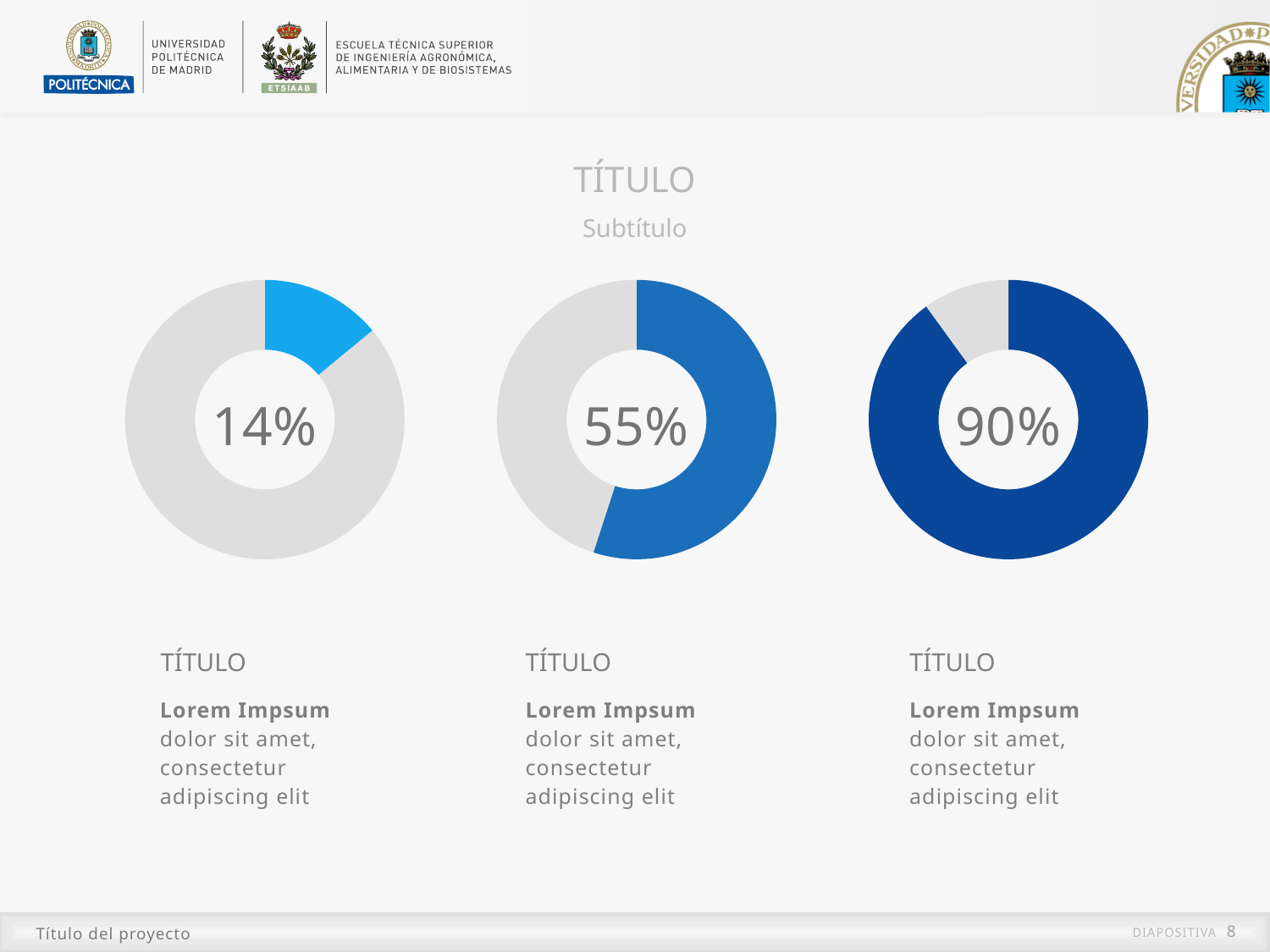
What is the difference between the percentage in the right donut chart and the percentage in the left donut chart? 76% What is the difference between the percentage in the middle donut chart and the percentage in the left donut chart? 41% What colour is the filled portion of the left donut chart? light blue Which of the three donut charts shows the lowest percentage: left, middle or right? left What percentage is shown in the centre of the middle donut chart? 55% Do the percentages increase or decrease going from the left chart to the right chart? increase How many donut charts are on the slide? 3 What percentage is shown in the centre of the right donut chart? 90% What percentage is shown in the centre of the left donut chart? 14% What kind of chart is used on this slide? donut chart Is the percentage in the middle donut chart larger or smaller than the percentage in the right donut chart? smaller Which of the three donut charts shows the highest percentage: left, middle or right? right